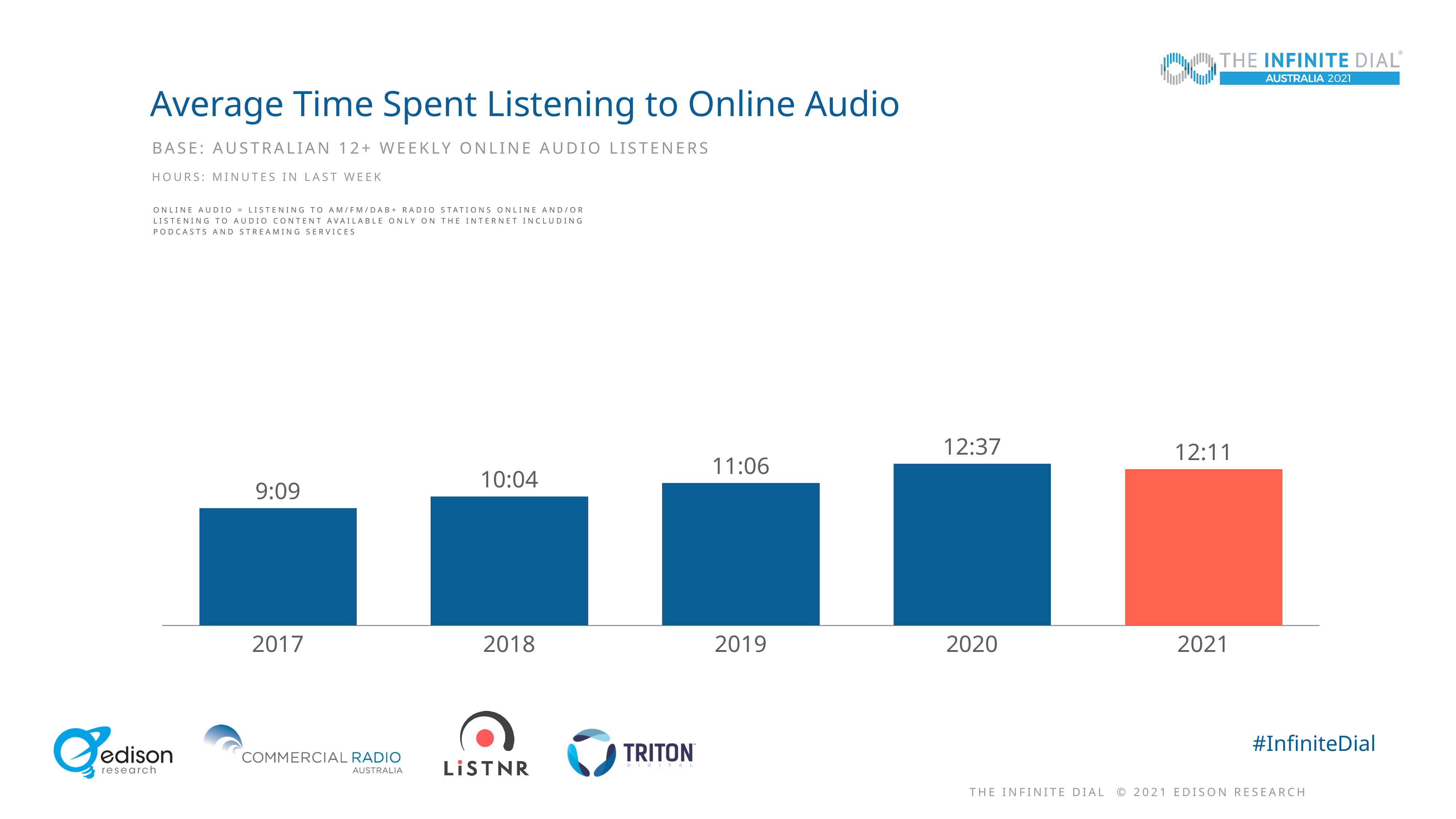
What is the average time spent listening to online audio in 2017? 9:09 What kind of chart is shown on the slide? bar chart Which year has the highest average time spent listening to online audio? 2020 What is the average time spent listening to online audio in 2019? 11:06 What is the title of the chart? Average Time Spent Listening to Online Audio Which year has the lowest average time spent listening to online audio? 2017 Do the values rise or fall from 2017 to 2020? rise Which year's bar is coloured differently (orange-red) from the others? 2021 What is the average time spent listening to online audio in 2021? 12:11 Which year has a larger value, 2018 or 2019? 2019 How many years are shown on the chart? 5 Is the value for 2020 larger or smaller than the value for 2021? larger